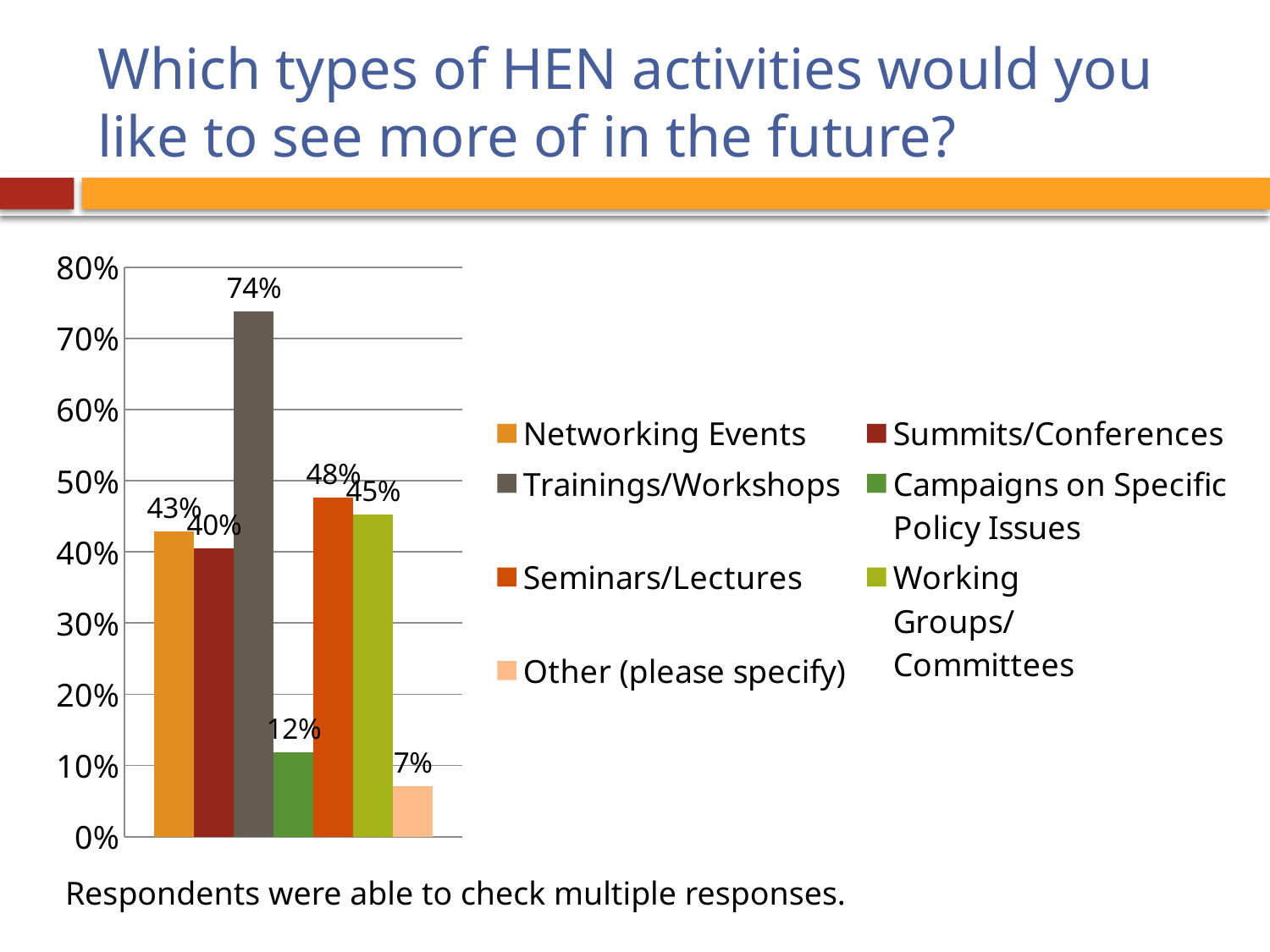
What is the value for Other (please specify)? 7% What is the difference between the values for Trainings/Workshops and Seminars/Lectures? 26% How many series does the legend list? 7 What is the difference between Networking Events and Summits/Conferences? 3% What kind of chart is shown on the slide? Bar chart Which activity type has the highest percentage? Trainings/Workshops What colour is the bar for Trainings/Workshops? Gray Which is larger, the value for Working Groups/Committees or the value for Campaigns on Specific Policy Issues? Working Groups/Committees What percentage of respondents wanted more Trainings/Workshops? 74% What is the value shown for Seminars/Lectures? 48% Which activity type has the lowest percentage? Other (please specify) What percentage is shown for Campaigns on Specific Policy Issues? 12%